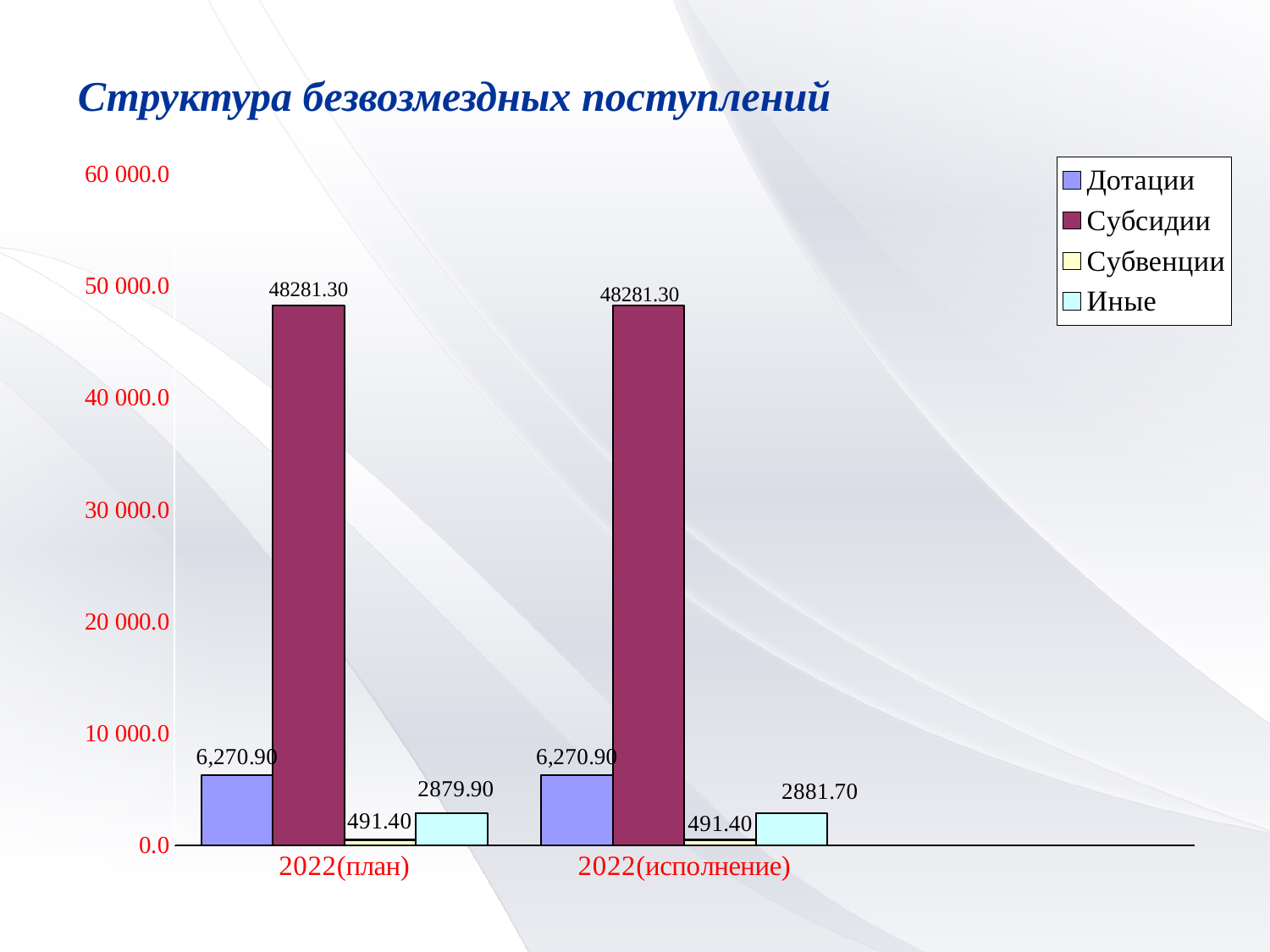
What type of chart is shown on the slide? Bar chart What is the value of Субвенции for 2022(исполнение)? 491.40 What is the value of Субсидии for 2022(план)? 48281.30 How many categories are shown on the x axis? 2 How many series does the legend list? 4 What is the value of Иные for 2022(исполнение)? 2881.70 Is the value of Субсидии for 2022(план) greater or less than 40 000.0? greater Which series has the highest value for 2022(исполнение)? Субсидии What is the value of Дотации for 2022(план)? 6,270.90 Which is larger for 2022(план): Дотации or Иные? Дотации Which series has the lowest value for 2022(план)? Субвенции What is the difference between Иные for 2022(исполнение) and Иные for 2022(план)? 1.80